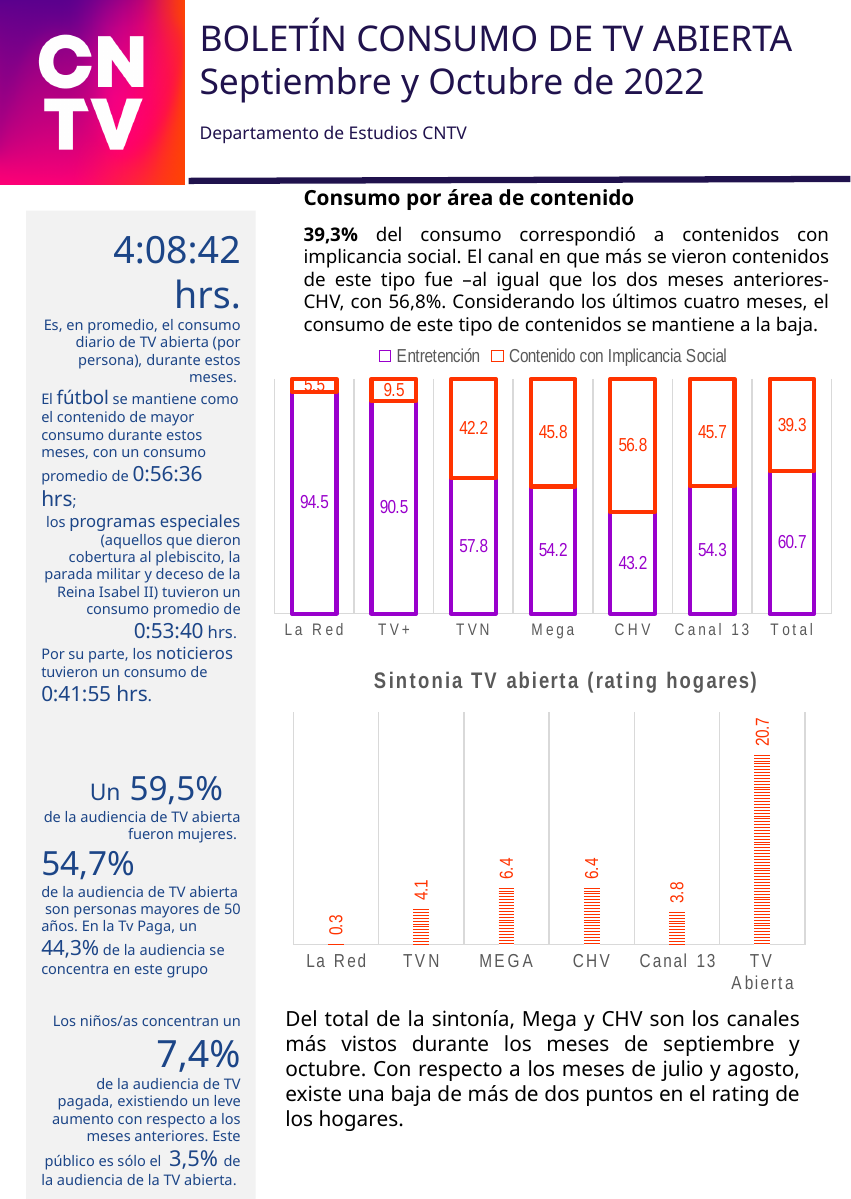
What kind of chart is the one titled Sintonia TV abierta (rating hogares)? Bar chart In the chart titled Sintonia TV abierta (rating hogares), what is the difference between the values for TV Abierta and MEGA? 14.3 In the chart titled Sintonia TV abierta (rating hogares), what is the value for Canal 13? 3.8 In the stacked bar chart at the top (Consumo por área de contenido), what is the difference between the Entretención values of TVN and Mega? 3.6 In the stacked bar chart at the top (Consumo por área de contenido), what is the value of Contenido con Implicancia Social for CHV? 56.8 In the stacked bar chart at the top (Consumo por área de contenido), how many categories are shown on the x axis? 7 In the chart titled Sintonia TV abierta (rating hogares), which category has the lowest value? La Red In the stacked bar chart at the top (Consumo por área de contenido), which channel has the highest Contenido con Implicancia Social value? CHV In the stacked bar chart at the top (Consumo por área de contenido), what is the value of Entretención for La Red? 94.5 In the chart titled Sintonia TV abierta (rating hogares), which is larger, the value for TVN or the value for Canal 13? TVN In the stacked bar chart at the top (Consumo por área de contenido), how many series does the legend list? 2 In the stacked bar chart at the top (Consumo por área de contenido), which category has the lowest Entretención value? CHV